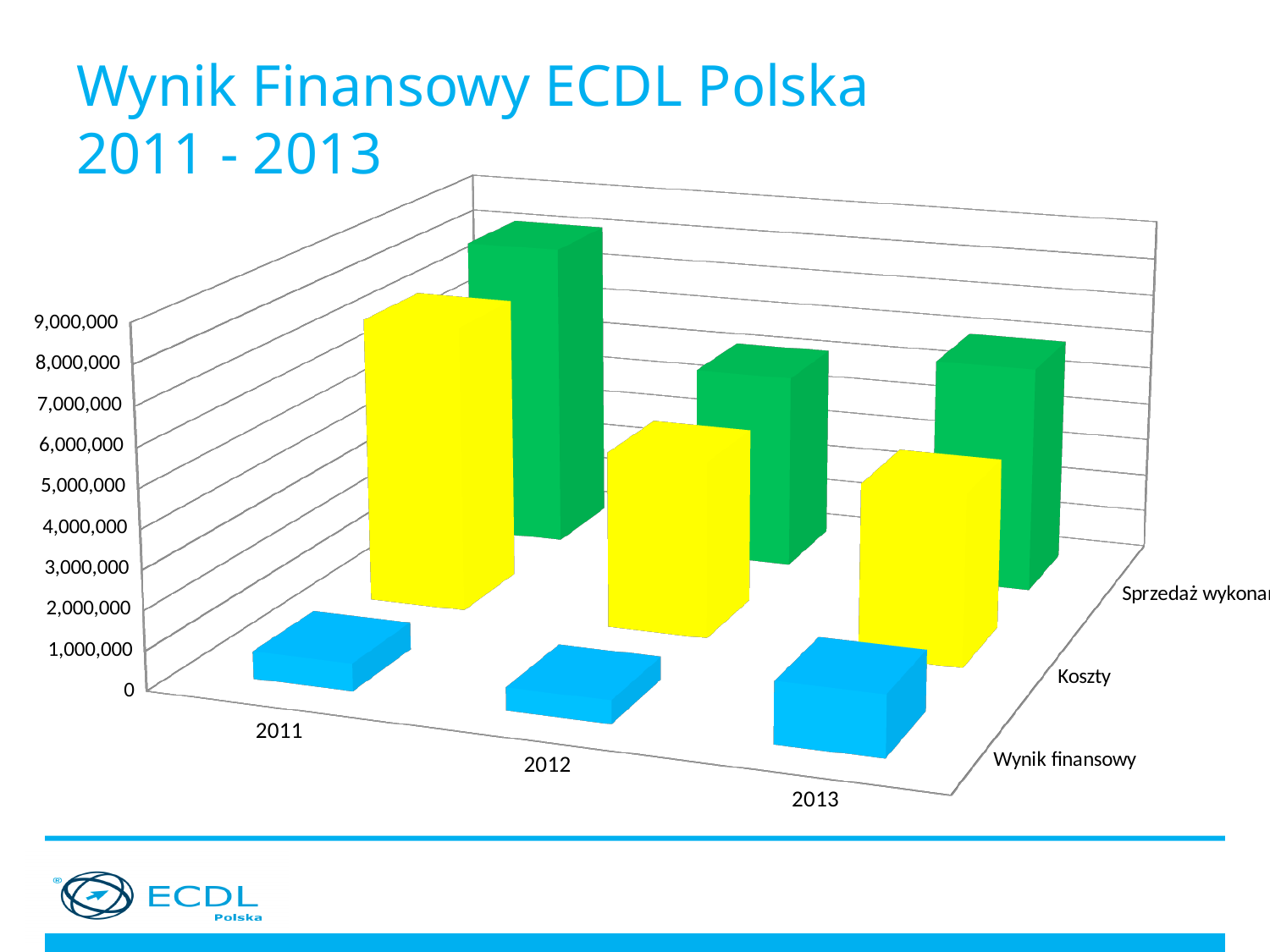
How many years (categories) are shown on the chart? 3 In which year is the Wynik finansowy value highest? 2013 Which is larger, Koszty in 2011 or Koszty in 2012? Koszty in 2011 In which year is the Koszty value highest? 2011 How many series does the chart show? 3 Is the Sprzedaż wykonana value for 2011 greater or less than 5,000,000? greater Is the Wynik finansowy value for 2011 greater or less than 3,000,000? less What colour are the Koszty bars? yellow What kind of chart is shown on the slide? bar chart Do the Koszty values rise or fall from 2011 to 2012? fall In which year is the Sprzedaż wykonana value highest? 2011 Is the Koszty value for 2012 greater or less than 7,000,000? less